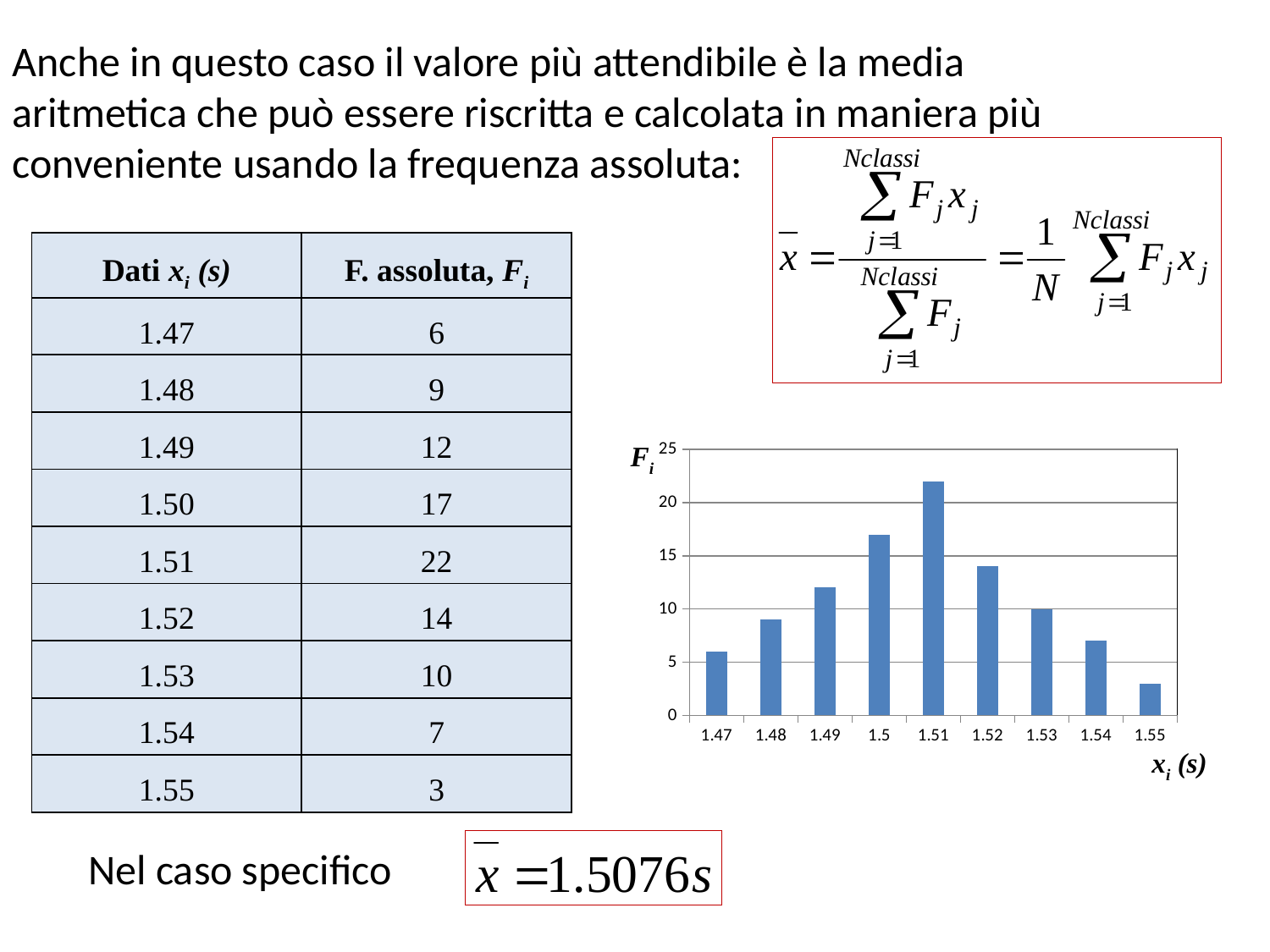
Do the bar values rise or fall from 1.51 to 1.55 along the x axis? fall Is the value for 1.48 greater or less than 10? less What is the value of the bar for 1.51? 22 Is the value for 1.5 greater or less than 15? greater What kind of chart is shown on the slide? bar chart Which x value has the lowest bar in the chart? 1.55 Which x value has the highest bar in the chart? 1.51 Which bar is taller, 1.49 or 1.54? 1.49 How many bars (categories) does the chart show? 9 What label is shown on the x axis of the chart? xi (s) Is the value for 1.52 greater or less than 15? less What is the value of the bar for 1.53? 10